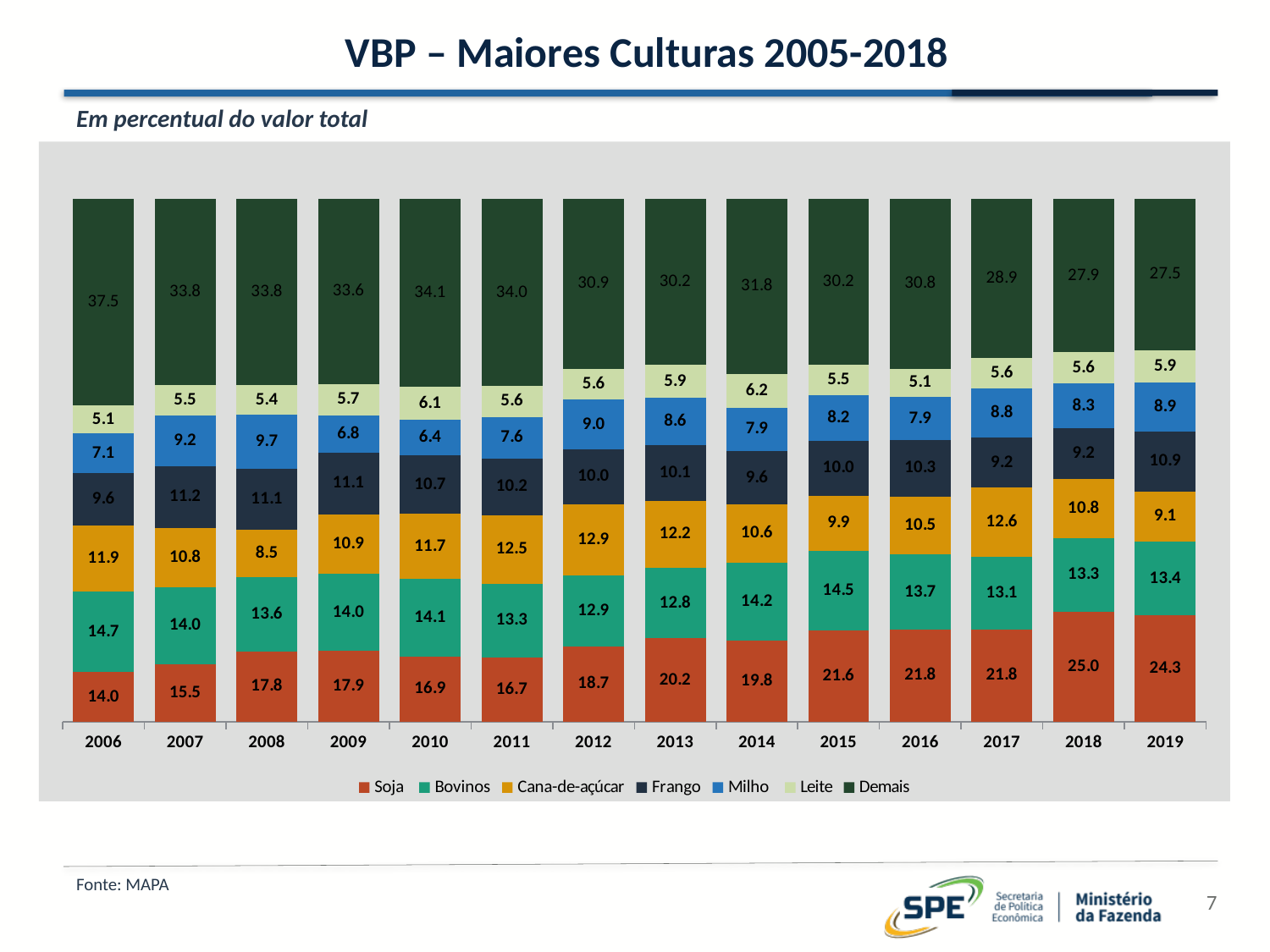
What is the difference between the Soja value in 2019 and in 2006? 10.3 Does the Soja share generally rise or fall from 2006 to 2019? Rise In which year is the Demais share lowest? 2019 In which year is the Soja share highest? 2018 How many years are shown along the x axis of the chart? 14 What is the total of the stacked bar for 2019? 100.0 How many series does the legend list? 7 What is the value for Soja in 2018? 25.0 In 2015, which is larger: Bovinos or Cana-de-açúcar? Bovinos What is the value for Leite in 2014? 6.2 What kind of chart is shown on the slide? Stacked bar chart What is the value for Milho in 2012? 9.0